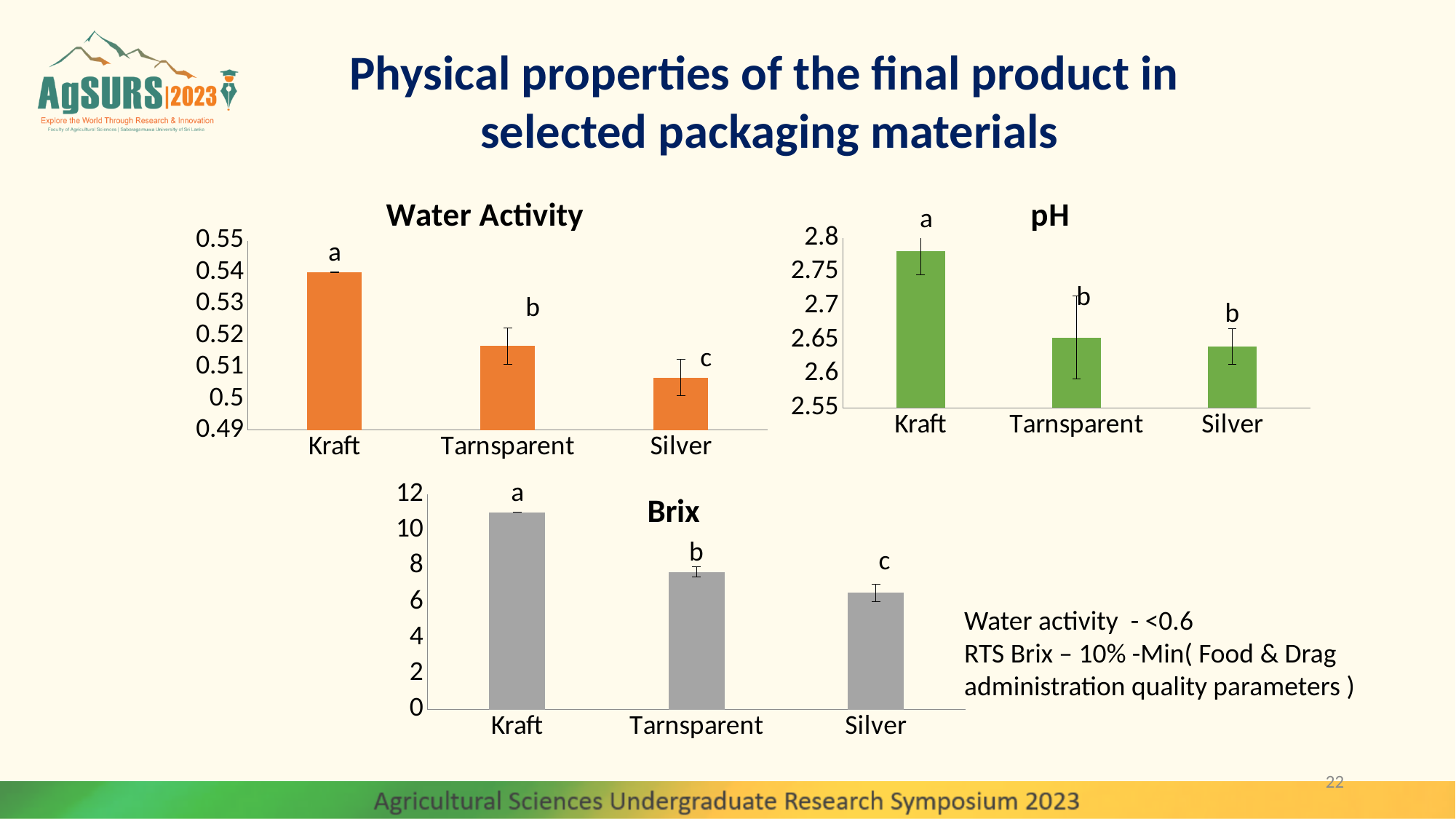
How many packaging materials are shown in the Brix chart? 3 In the Water Activity chart, is the value for Silver greater or less than 0.51? less In the Brix chart, which packaging material has the lowest value? Silver In the Brix chart, is the value for Kraft greater or less than 10? greater In the pH chart, is the value for Silver greater or less than 2.7? less In the pH chart, which packaging material has the highest value? Kraft In the Water Activity chart, which packaging material has the highest value? Kraft In the Brix chart, which is larger, the value for Tarnsparent or the value for Silver? Tarnsparent What type of chart is the pH chart? bar chart In the Water Activity chart, which packaging material has the lowest value? Silver